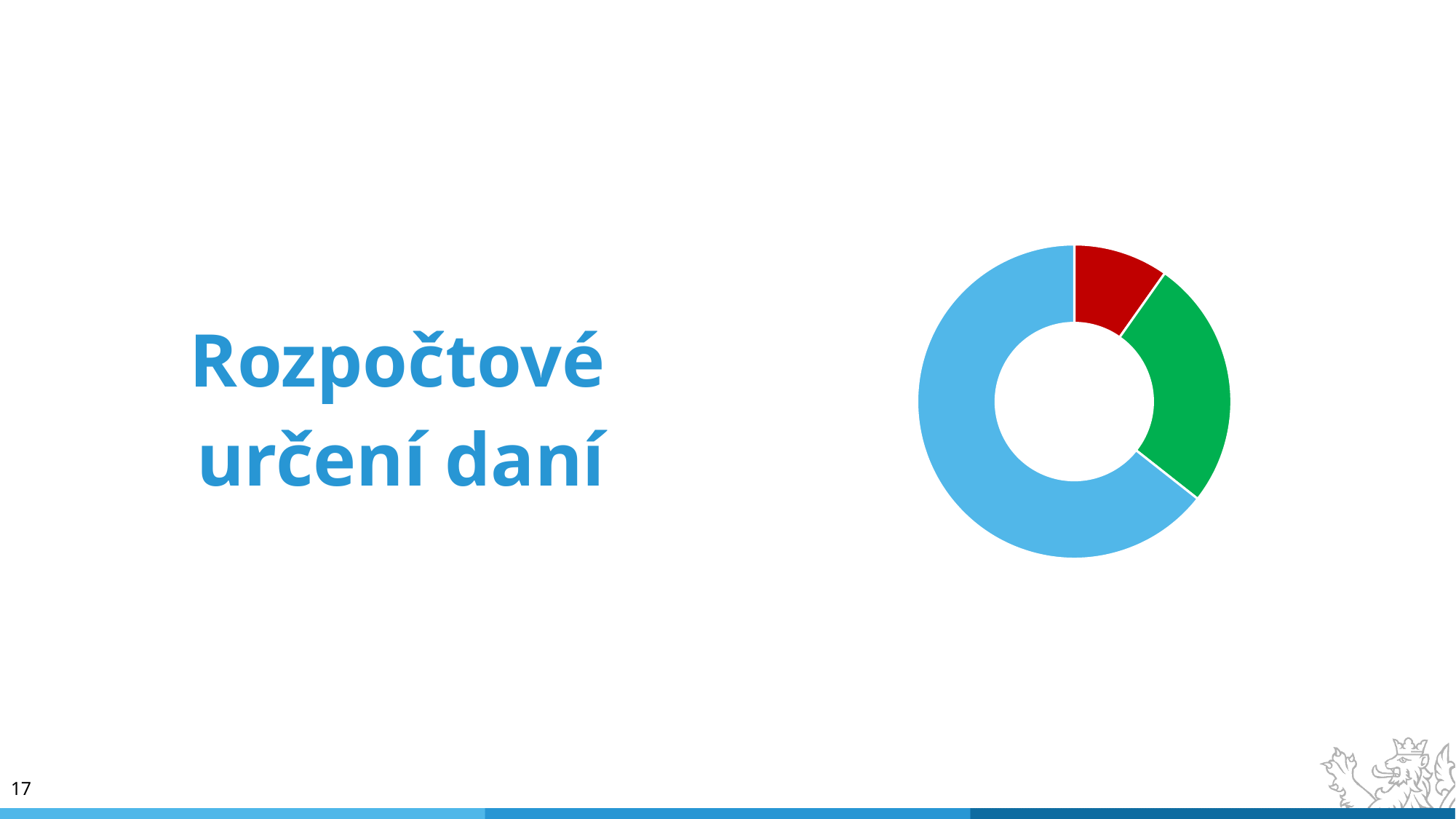
Which colour slice is the smallest in the doughnut chart? red Which slice is larger in the doughnut chart, the light blue one or the green one? light blue What kind of chart is shown on the slide? doughnut (pie) chart Which slice is larger in the doughnut chart, the green one or the red one? green Does the light blue slice take up more or less than half of the doughnut chart? more Which colour slice is the largest in the doughnut chart? light blue Does the doughnut chart display a legend? No What text appears to the left of the doughnut chart on the slide? Rozpočtové určení daní How many slices does the doughnut chart have? 3